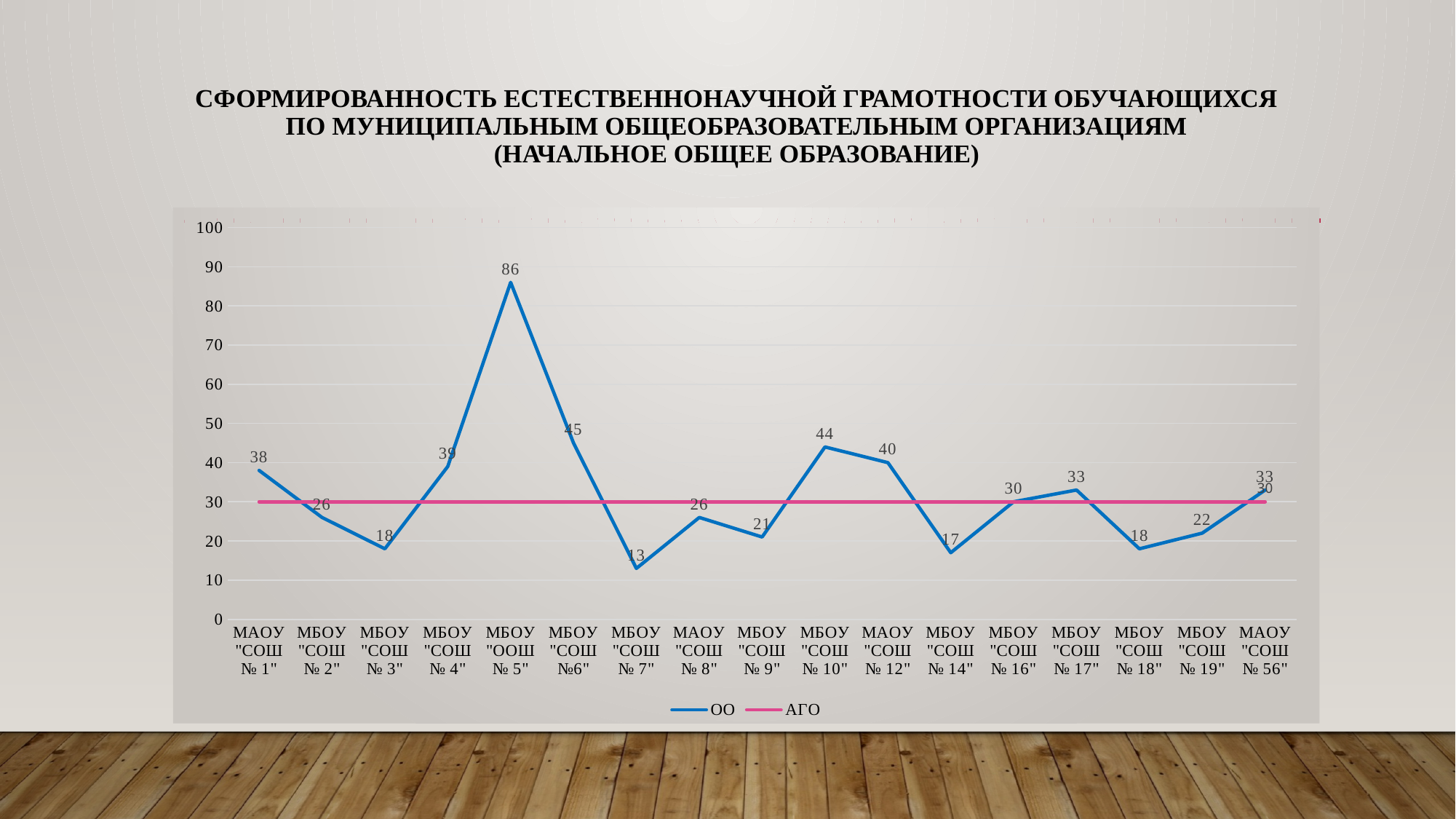
How many organisations are shown on the x axis? 17 What is the value of the ОО series for МБОУ "ООШ № 5"? 86 What is the difference between the ОО values for МБОУ "ООШ № 5" and МБОУ "СОШ №6"? 41 What kind of chart is shown on the slide? Line chart What is the value of the ОО series for МАОУ "СОШ № 1"? 38 How many series does the legend list? 2 Which series is drawn in pink? АГО Which organisation has the lowest ОО value? МБОУ "СОШ № 7" Which has a larger ОО value, МБОУ "СОШ № 4" or МБОУ "СОШ № 3"? МБОУ "СОШ № 4" What is the value of the АГО series for МАОУ "СОШ № 56"? 30 What is the value of the ОО series for МБОУ "СОШ № 10"? 44 Which organisation has the highest ОО value? МБОУ "ООШ № 5"